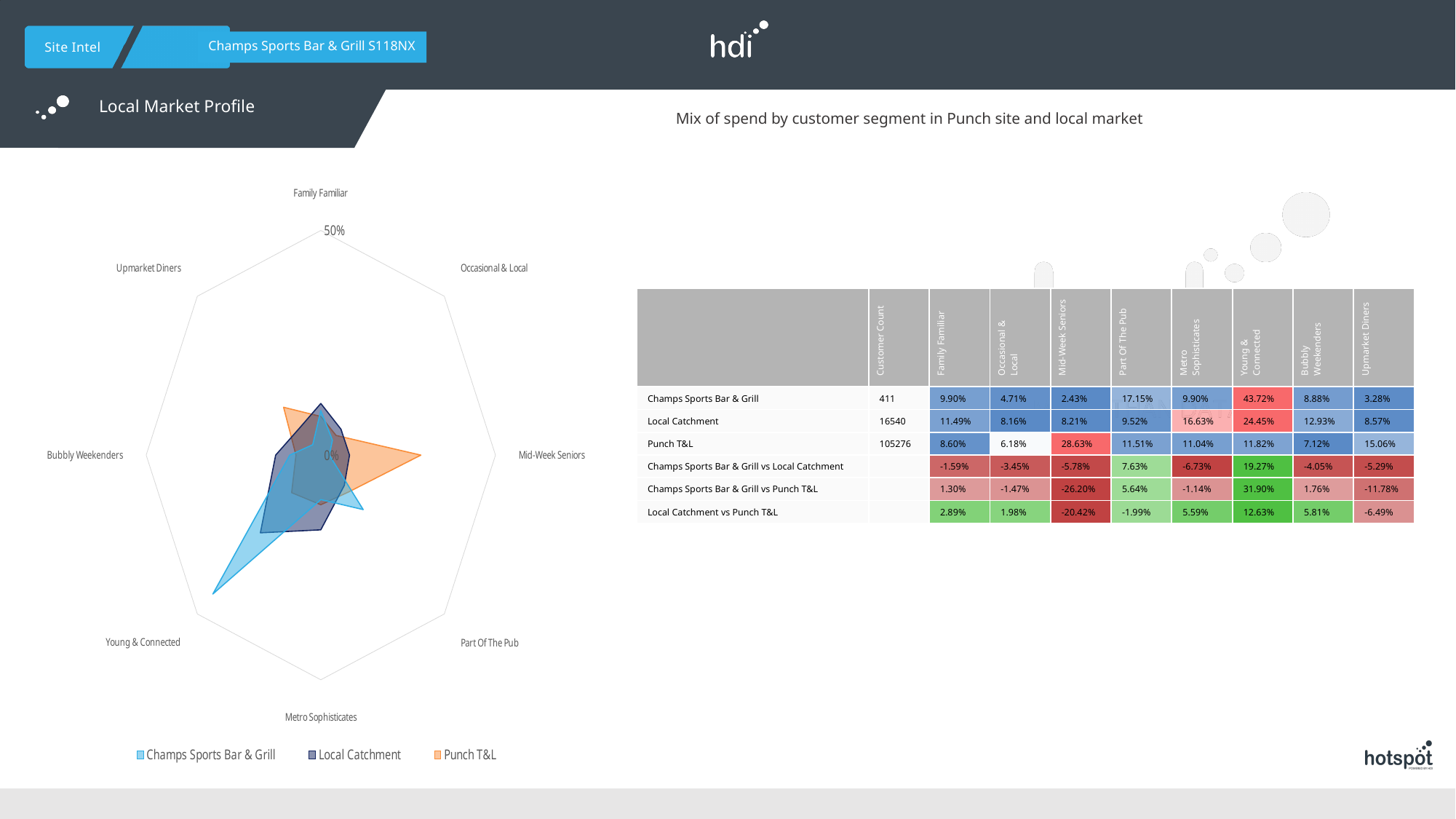
Which customer segment has the highest share of spend for Champs Sports Bar & Grill? Young & Connected How many series does the radar chart legend list? 3 How many customer segments are plotted around the radar chart? 8 Is the Young & Connected value for Champs Sports Bar & Grill greater or less than 50% on the radar chart? less What is the Mid-Week Seniors share of spend for Punch T&L? 28.63% For the Young & Connected segment, which is larger: Champs Sports Bar & Grill or Local Catchment? Champs Sports Bar & Grill What kind of chart is shown on the left of the slide? Radar chart What is the Young & Connected share of spend for Champs Sports Bar & Grill? 43.72% Which customer segment has the lowest share of spend for Champs Sports Bar & Grill? Mid-Week Seniors What is the difference between Champs Sports Bar & Grill and Local Catchment for the Young & Connected segment? 19.27% What colour represents Punch T&L in the radar chart legend? Orange Which customer segment has the highest share of spend for Punch T&L? Mid-Week Seniors